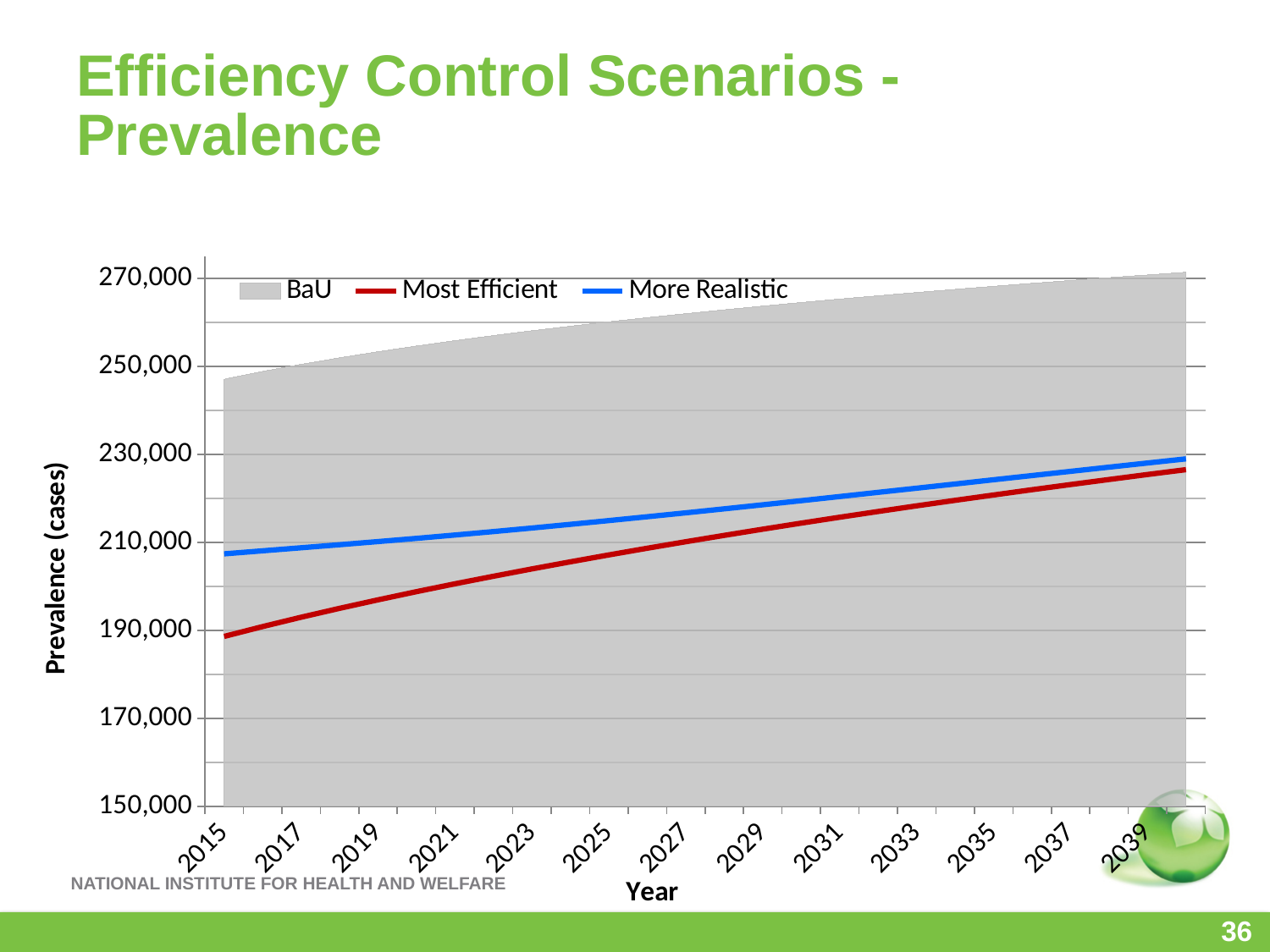
How many series does the chart legend list? 3 Does the Most Efficient series rise or fall from 2015 to 2039? rise Is the Most Efficient value in 2015 greater or less than 210,000? less Is the More Realistic value in 2039 greater or less than 210,000? greater What are the three series named in the chart legend? BaU, Most Efficient, More Realistic Is the BaU value in 2039 greater or less than 250,000? greater In 2015, which is larger: the More Realistic value or the Most Efficient value? More Realistic What is the title of the chart's vertical axis? Prevalence (cases) Does the BaU series rise or fall across the years shown? rise How many year labels are shown on the x axis? 13 In 2039, which is larger: the BaU value or the More Realistic value? BaU What kind of chart is shown on the slide? area and line chart